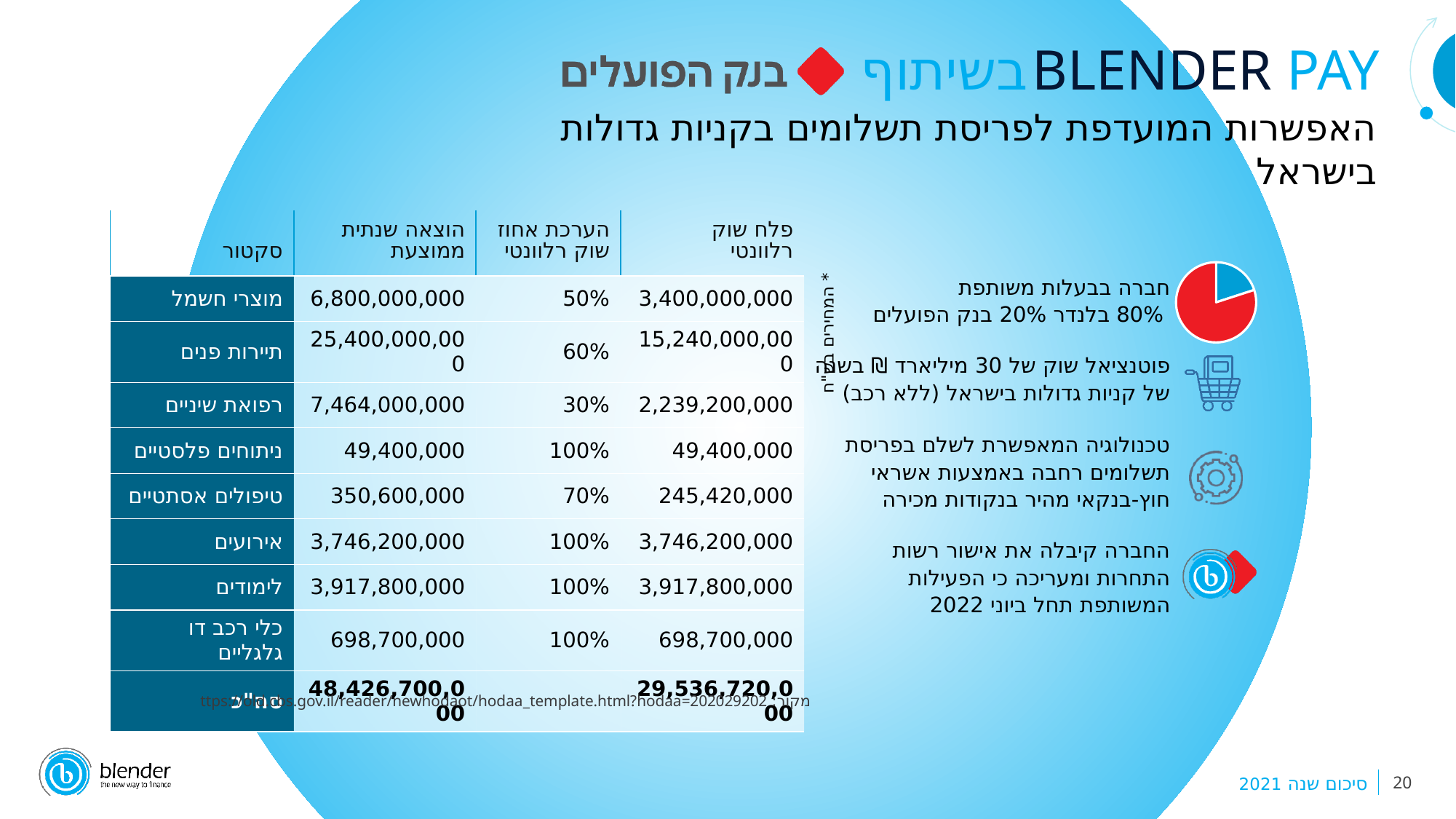
In the pie chart, what is the difference between Blender's share and Bank Hapoalim's share? 60% In the pie chart, which owner has the smallest share? Bank Hapoalim How many slices does the pie chart have? 2 In the pie chart, which owner has the largest share? Blender In the pie chart, what colour is the larger slice? red In the pie chart, what share of the jointly owned company does Bank Hapoalim hold? 20% In the pie chart, is Blender's share greater or less than 50%? greater In the pie chart, what share of the jointly owned company does Blender hold? 80% What kind of chart is shown next to the text about the jointly owned company? pie chart In the pie chart, which holds the larger share: Blender or Bank Hapoalim? Blender In the pie chart, what colour is the slice representing Bank Hapoalim's 20%? blue